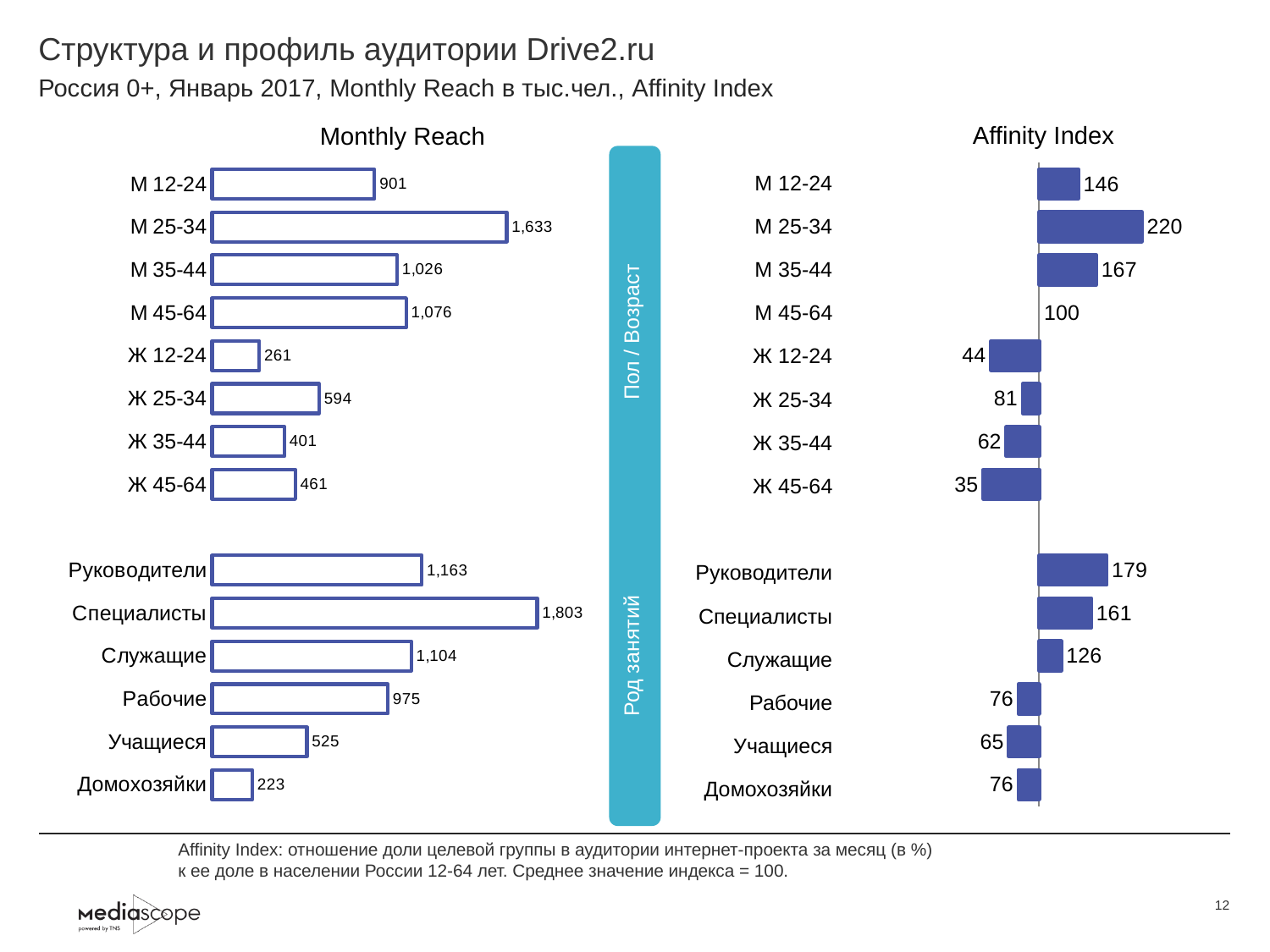
How many categories are shown in the Monthly Reach chart? 14 In the Monthly Reach chart, which is larger: М 35-44 or М 45-64? М 45-64 In the Monthly Reach chart, what is the value for М 25-34? 1,633 In the Monthly Reach chart, what is the value for Домохозяйки? 223 In the Affinity Index chart, what is the value for Ж 45-64? 35 In the Affinity Index chart, which category has the lowest value? Ж 45-64 What kind of chart is the Affinity Index chart? Bar chart In the Affinity Index chart, which is larger: Руководители or Специалисты? Руководители In the Affinity Index chart, what is the difference between М 25-34 and М 12-24? 74 In the Affinity Index chart, what is the value for Служащие? 126 In the Monthly Reach chart, which category has the highest value? Специалисты In the Monthly Reach chart, what is the difference between Специалисты and Руководители? 640